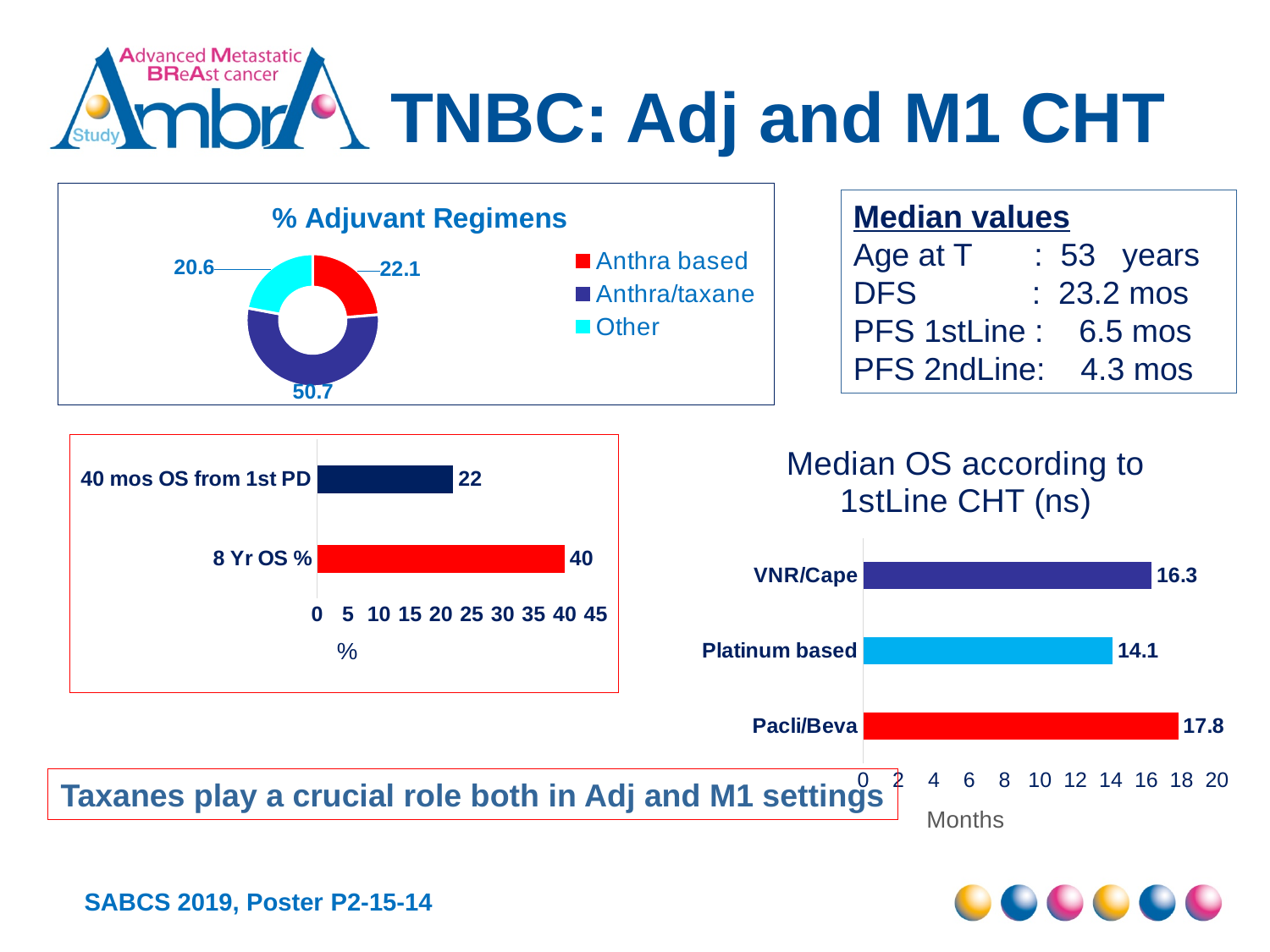
In the '% Adjuvant Regimens' chart, what colour represents Anthra based? Red In the '% Adjuvant Regimens' chart, what is the value for Anthra/taxane? 50.7 In the bottom-left bar chart, what is the value for '8 Yr OS %'? 40 In the bottom-left bar chart, what is the difference between the '8 Yr OS %' value and the '40 mos OS from 1st PD' value? 18 In the 'Median OS according to 1stLine CHT (ns)' chart, what is the value for Platinum based? 14.1 In the bottom-left bar chart, what is the value for '40 mos OS from 1st PD'? 22 In the '% Adjuvant Regimens' chart, what is the value for Other? 20.6 In the 'Median OS according to 1stLine CHT (ns)' chart, which 1st-line CHT has the lowest median OS? Platinum based In the 'Median OS according to 1stLine CHT (ns)' chart, what is the difference between the Pacli/Beva and VNR/Cape values? 1.5 In the 'Median OS according to 1stLine CHT (ns)' chart, which 1st-line CHT has the highest median OS? Pacli/Beva In the '% Adjuvant Regimens' chart, which regimen category has the largest share? Anthra/taxane In the '% Adjuvant Regimens' chart, how many categories does the legend list? 3